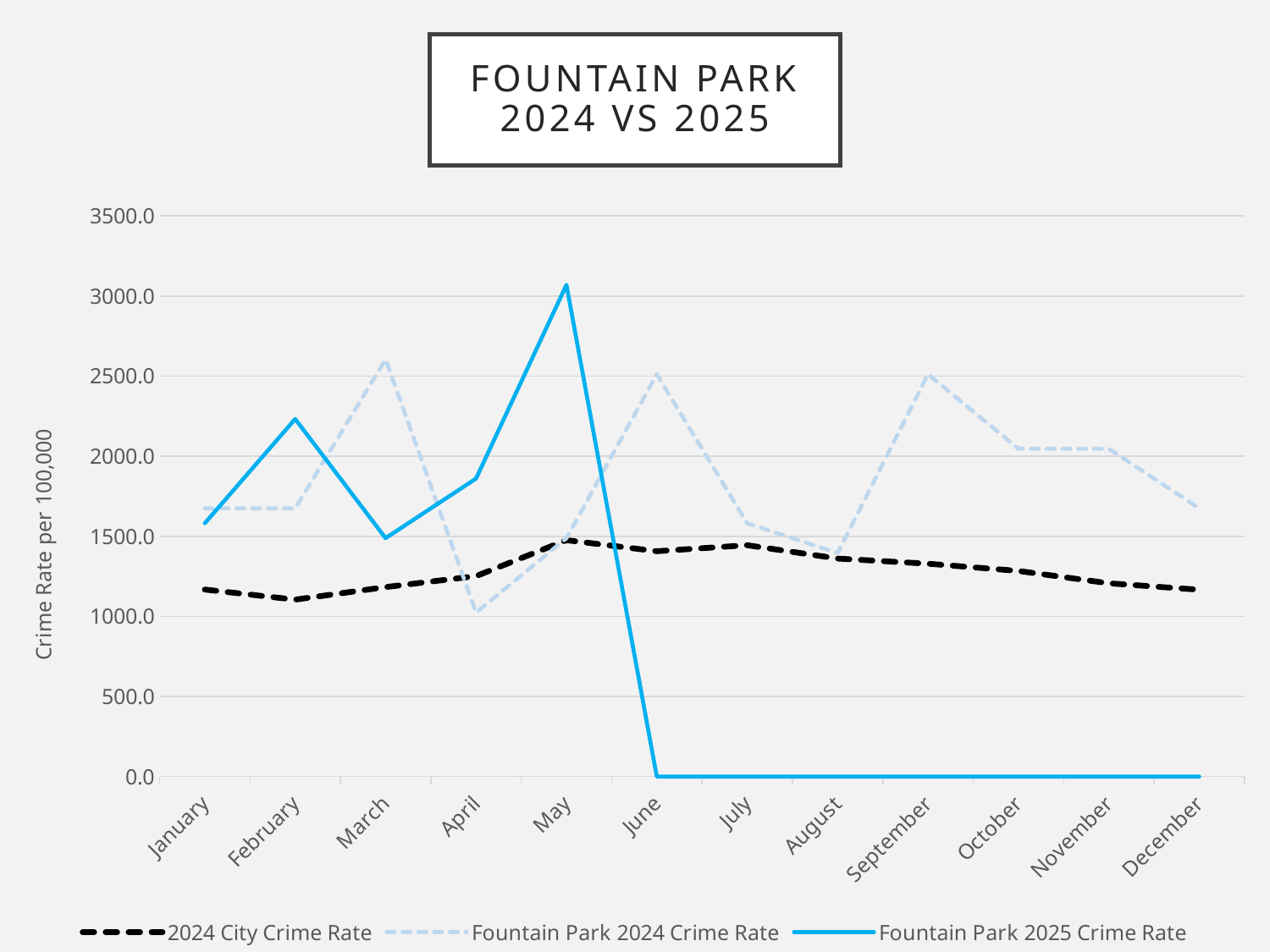
Is the 2024 City Crime Rate in January greater or less than 1500? less What is the label on the y axis? Crime Rate per 100,000 Is the Fountain Park 2024 Crime Rate in April greater or less than 1500? less Is the Fountain Park 2025 Crime Rate in February greater or less than 2000? greater How many series does the legend list? 3 Does the 2024 City Crime Rate rise or fall from July to December? fall In which month does the Fountain Park 2025 Crime Rate reach its highest value? May In March, which is larger: the Fountain Park 2024 Crime Rate or the Fountain Park 2025 Crime Rate? Fountain Park 2024 Crime Rate What kind of chart is shown on the slide? line chart What is the value of the Fountain Park 2025 Crime Rate in June? 0.0 How many months are plotted along the x axis? 12